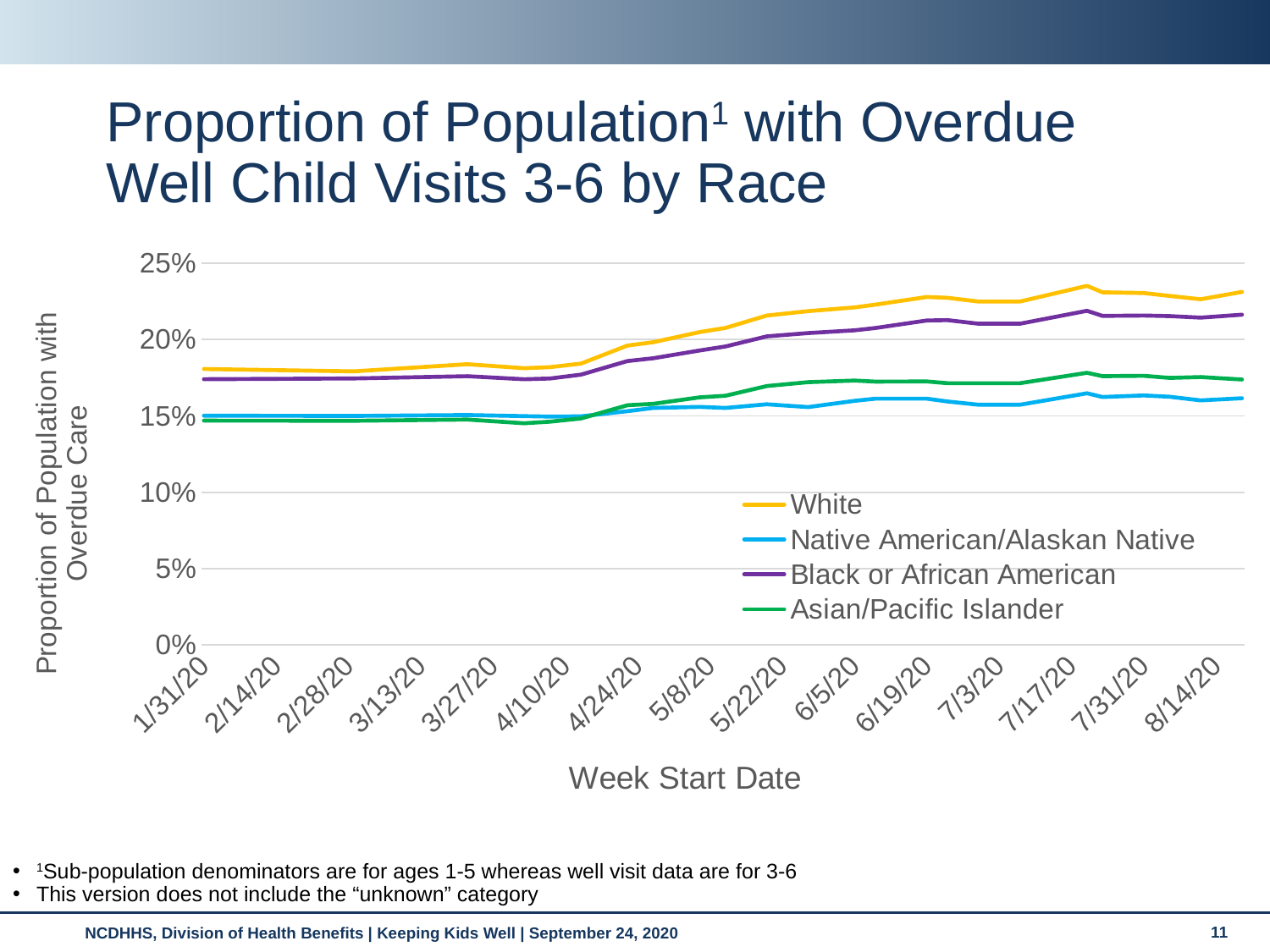
Which is larger at 7/17/20, the value for White or the value for Asian/Pacific Islander? White Is the value for White at 8/14/20 greater or less than 20%? greater What is the title of the x axis? Week Start Date How many week start dates are labelled on the x axis? 15 Which series has the highest value at 8/14/20? White Is the value for Native American/Alaskan Native at 8/14/20 greater or less than 20%? less Is the value for Black or African American at 1/31/20 greater or less than 15%? greater Which series has the lowest value at 8/14/20? Native American/Alaskan Native How many series does the legend list? 4 What kind of chart is shown on the slide? line chart Do the values for White generally rise or fall from 1/31/20 to 8/14/20? rise